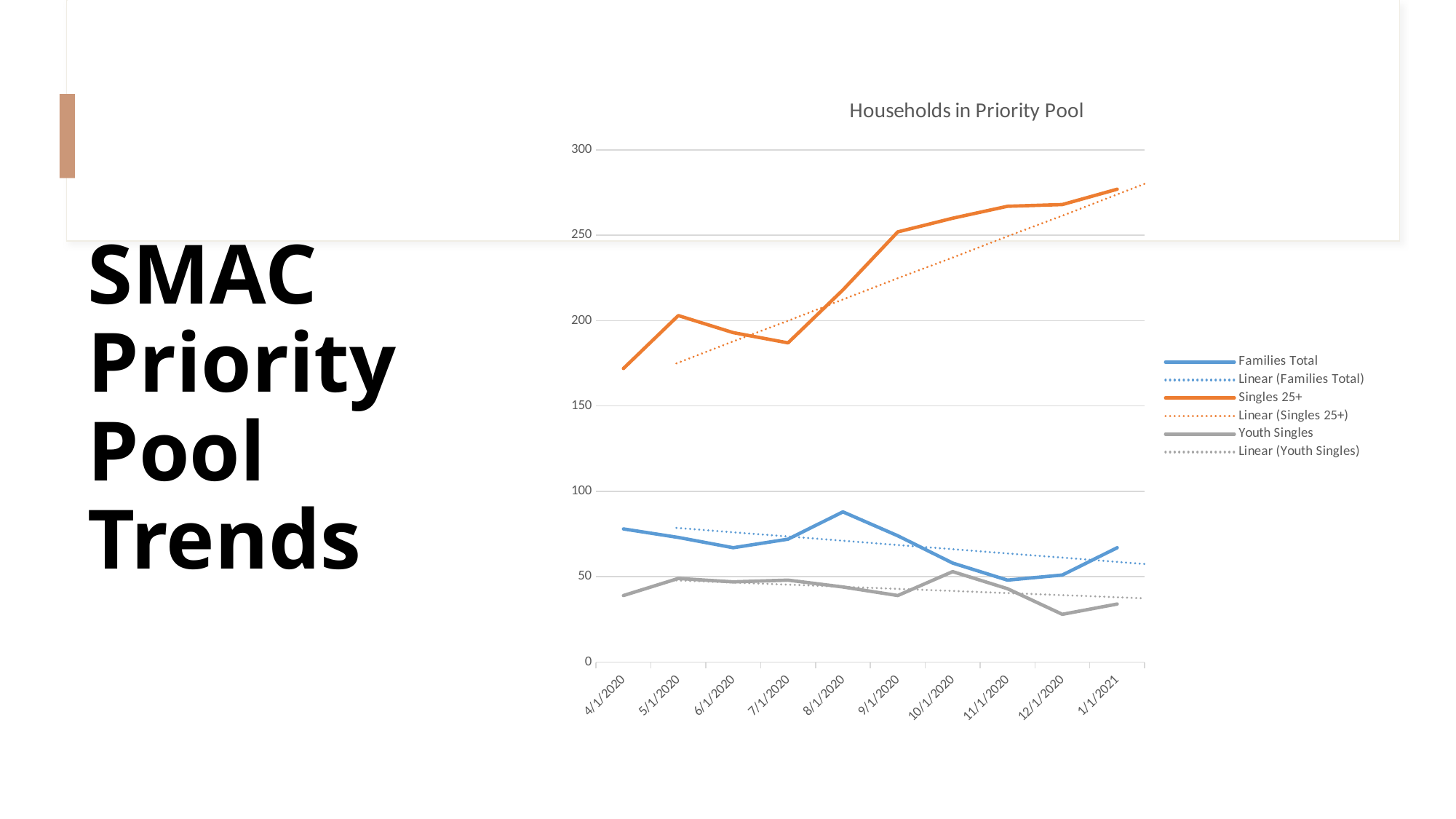
What is the title of the chart? Households in Priority Pool On which date does the Families Total series reach its highest value? 8/1/2020 What kind of chart is shown on the slide? line chart On which date does the Singles 25+ series reach its highest value? 1/1/2021 Is the value for Singles 25+ on 1/1/2021 greater or less than 250? greater Is the value for Youth Singles on 12/1/2020 greater or less than 50? less How many entries does the chart's legend list? 6 Is the value for Families Total on 8/1/2020 greater or less than 100? less How many dates are plotted along the x axis of the chart? 10 Which series is higher on 9/1/2020, Singles 25+ or Families Total? Singles 25+ On which date does the Youth Singles series reach its lowest value? 12/1/2020